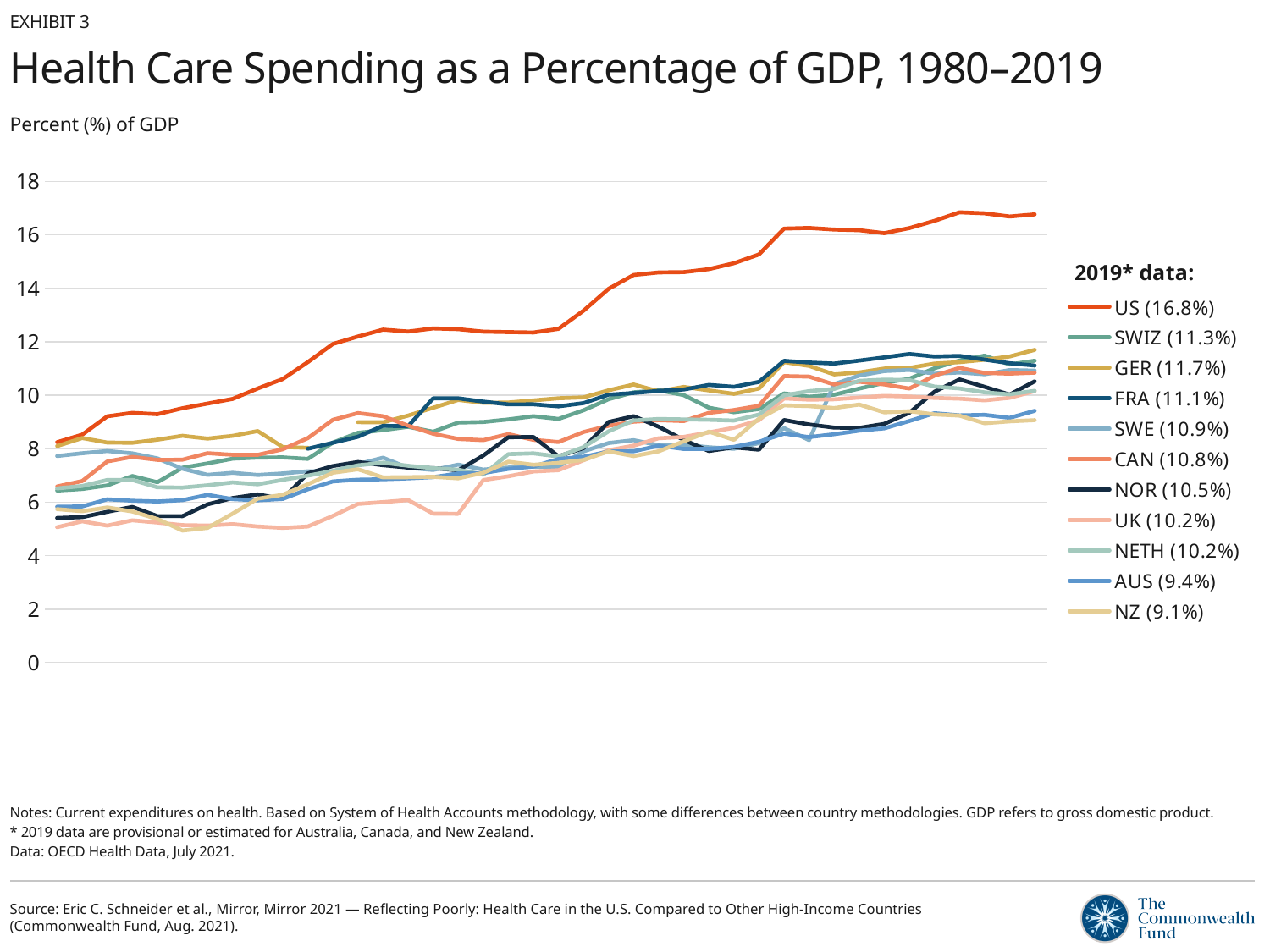
How many countries (series) does the legend list? 11 What kind of chart is shown on the slide? line chart What is the 2019 value shown for GER? 11.7% Does the US line rise or fall over the period from 1980 to 2019? rise What is the title of the chart? Health Care Spending as a Percentage of GDP, 1980–2019 What is the difference between the 2019 values for the US and SWIZ? 5.5% Which country has the highest 2019 value? US What is the 2019 value shown for NETH? 10.2% Which has the larger 2019 value, GER or FRA? GER Which country has the lowest 2019 value? NZ Is the US value at the start of the period (1980) greater or less than 10? less What is the 2019 health care spending as a percentage of GDP for the US? 16.8%